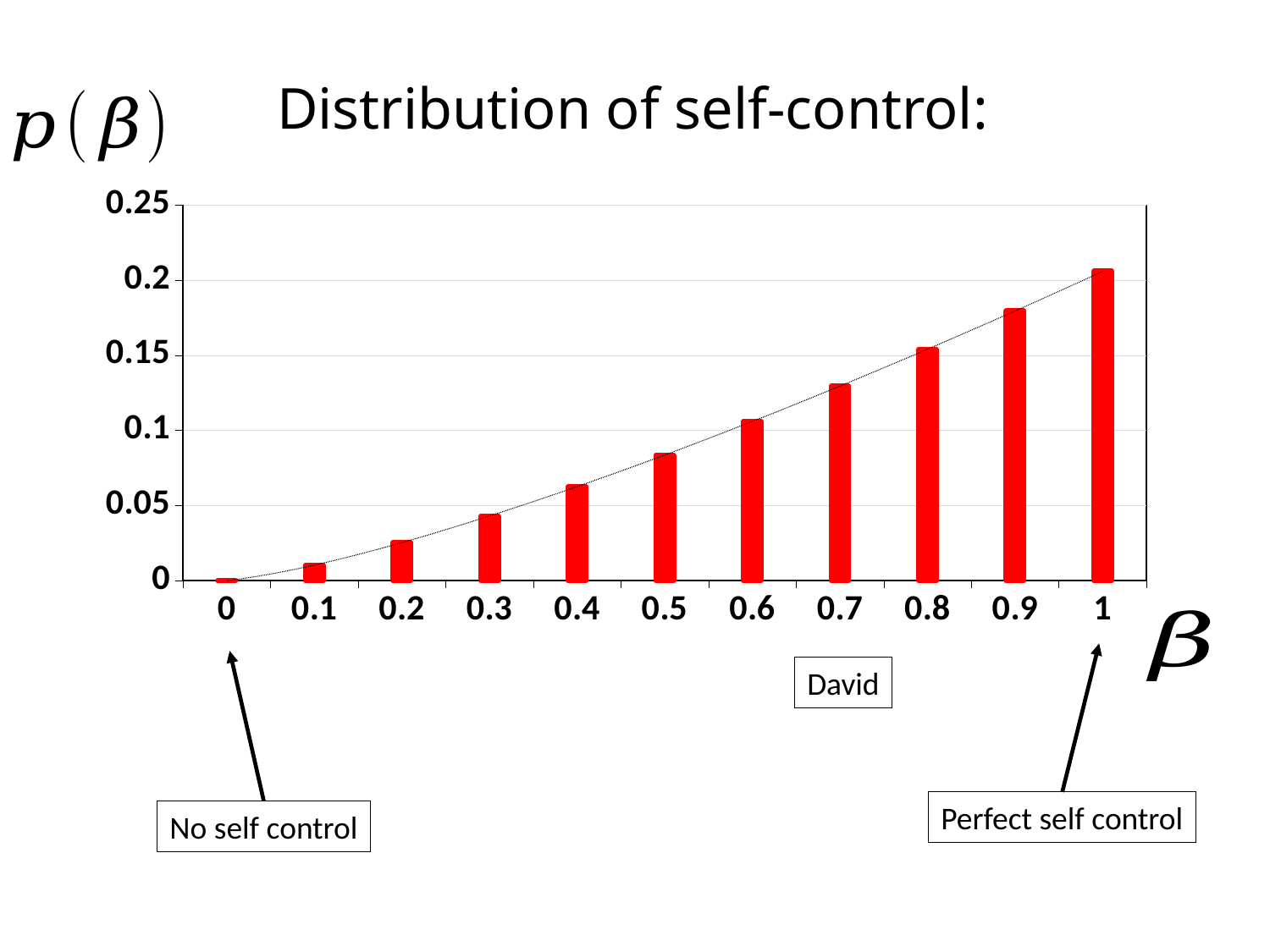
Which β value has the lowest bar? 0 What colour are the bars in the chart? red Which β value has the highest bar? 1 Is the value for β = 0.3 greater or less than 0.05? less What is the title of the chart? Distribution of self-control: Do the bar heights rise or fall as β increases from 0 to 1? rise Is the value for β = 1 greater or less than 0.2? greater Is the value for β = 0.5 greater or less than 0.1? less Which has the larger value, β = 0.4 or β = 0.7? 0.7 What kind of chart is shown on the slide? bar chart How many bars are plotted in the chart? 11